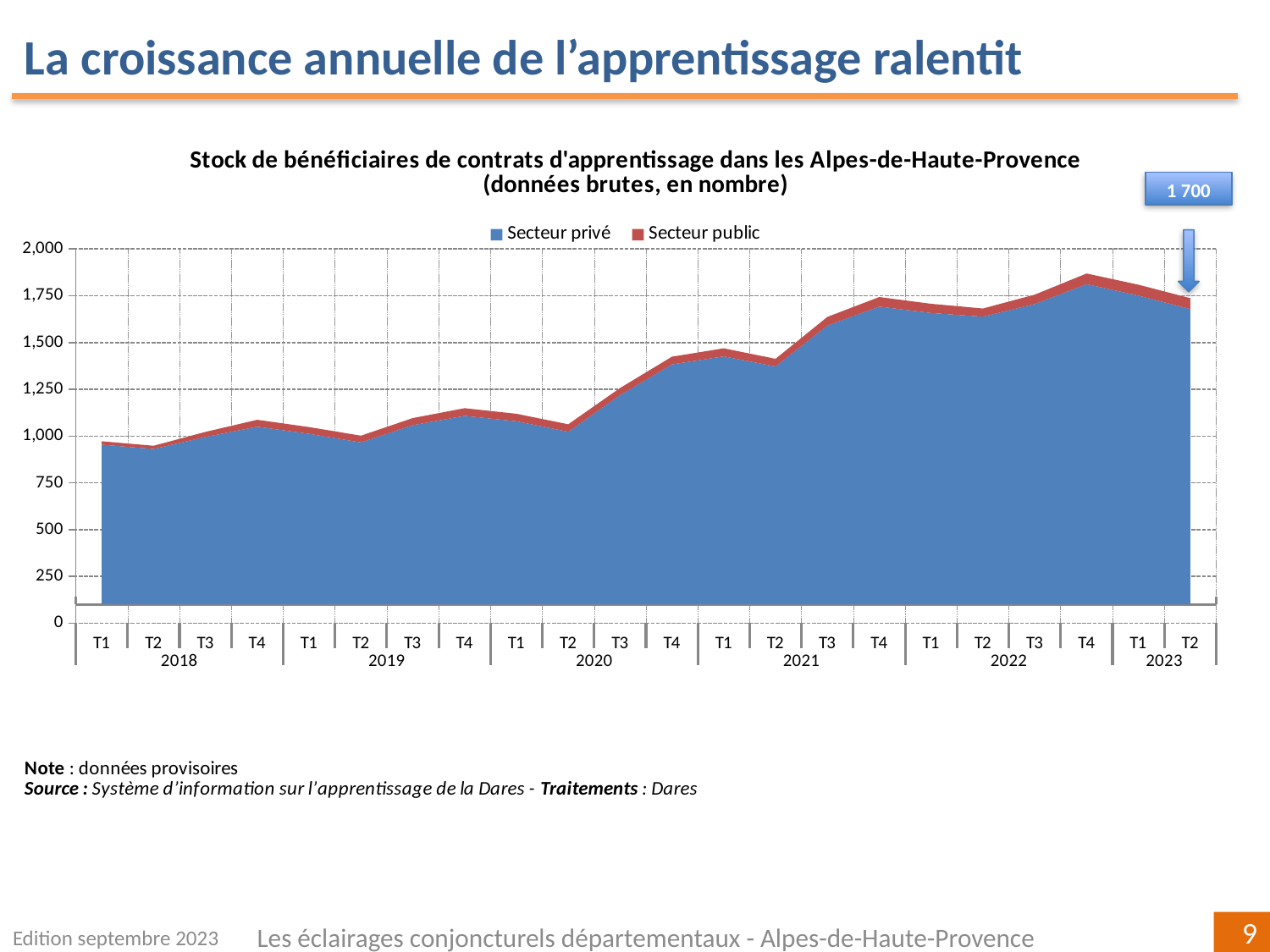
Which is larger, the total for T4 2022 or the total for T2 2023? T4 2022 Is the total value for T4 2022 greater or less than 1,750? greater In which quarter does the total stock reach its highest level? T4 2022 How many series does the legend list? 2 What is the total stock of apprenticeship beneficiaries shown for T2 2023? 1 700 Is the total value for T4 2019 greater or less than 1,000? greater Does the total stock generally rise or fall from 2018 to 2023? Rise What are the two series named in the legend? Secteur privé and Secteur public What kind of chart is shown on the slide? Stacked area chart Which series accounts for the larger share of the stock, Secteur privé or Secteur public? Secteur privé How many quarterly data points are plotted on the chart? 22 Is the total value for T1 2021 greater or less than 1,500? less